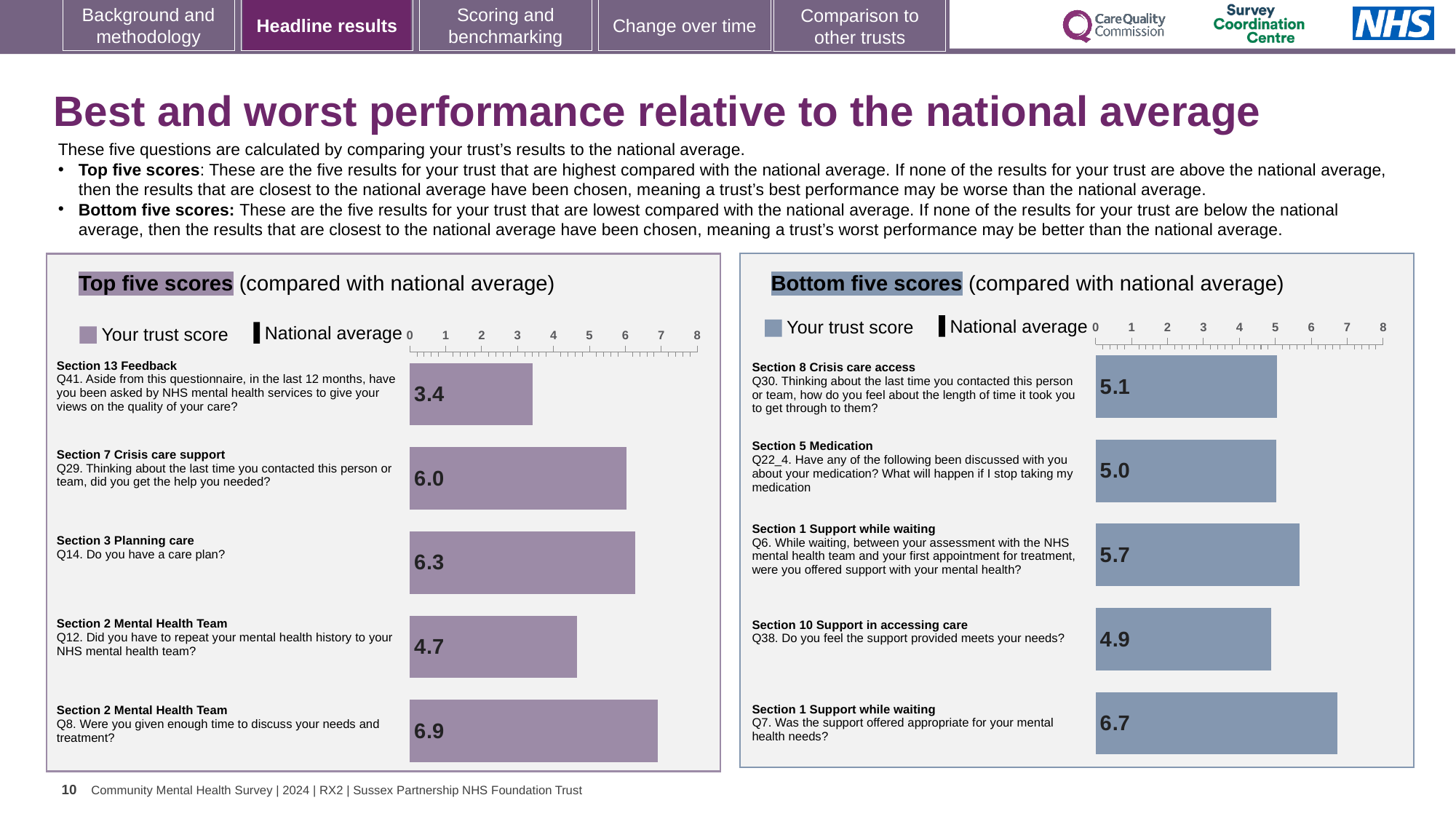
In the Top five scores chart, what is the difference between the trust scores for Q8 and Q41? 3.5 In the Bottom five scores chart, which has the larger trust score, Q30 or Q7? Q7 How many questions are shown in the Bottom five scores chart? 5 In the Top five scores chart, what is the trust score for Q14 (Do you have a care plan?)? 6.3 In the Top five scores chart, which question has the lowest trust score? Q41 In the Bottom five scores chart, what is the trust score for Q38 (Do you feel the support provided meets your needs?)? 4.9 What type of chart is the Top five scores chart? Bar chart In the Bottom five scores chart, what is the trust score for Q6 (offered support while waiting)? 5.7 In the Top five scores chart, what is the trust score for Q41 (asked to give views on the quality of your care)? 3.4 In the Top five scores chart, which question has the highest trust score? Q8 In the Bottom five scores chart, which question has the lowest trust score? Q38 In the Bottom five scores chart, which question has the highest trust score? Q7